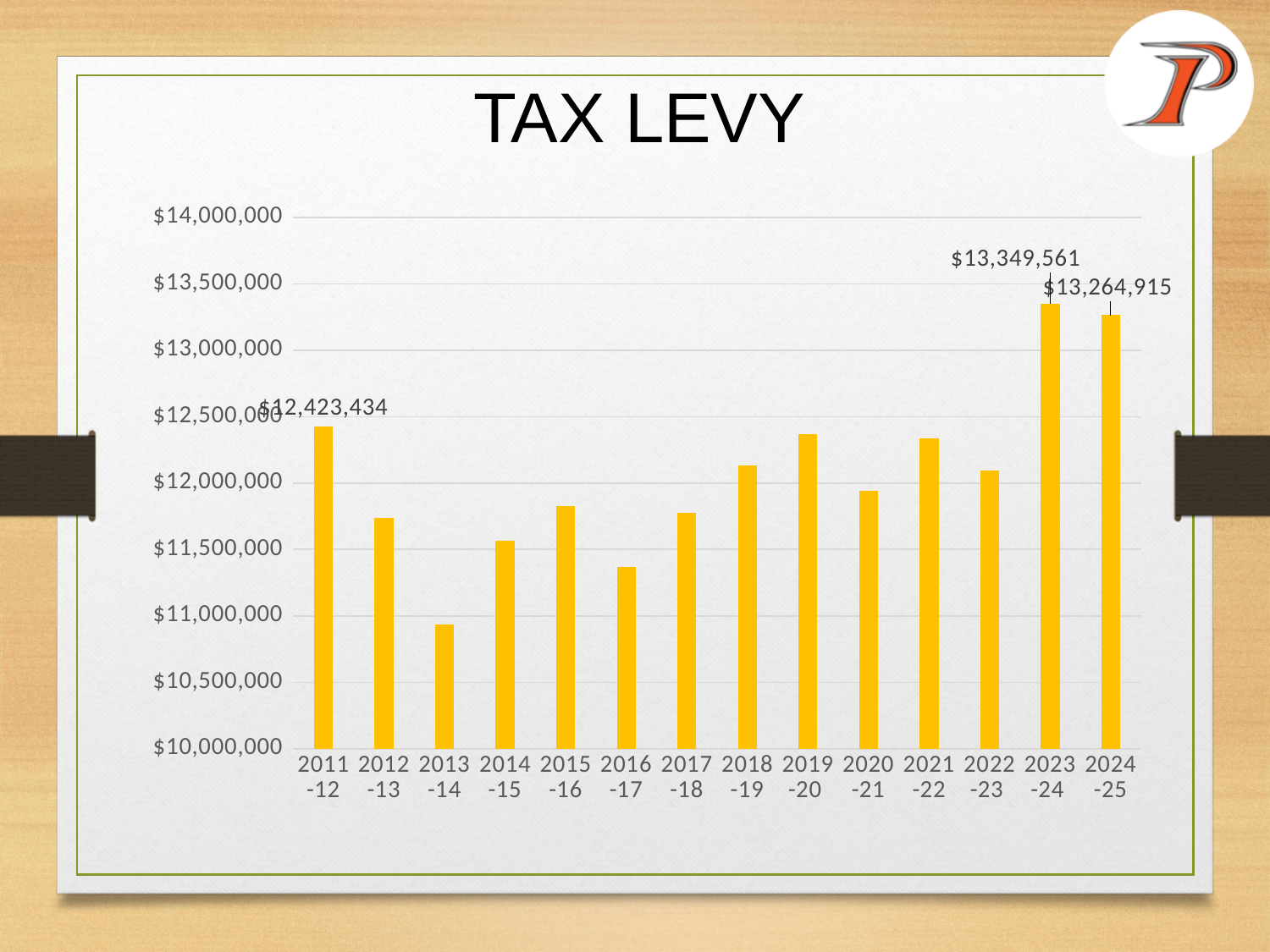
Is the value for 2013-14 greater or less than $11,000,000? less Which is larger, the tax levy for 2019-20 or for 2020-21? 2019-20 Is the value for 2019-20 greater or less than $12,000,000? greater What is the tax levy value for 2024-25? $13,264,915 What is the difference between the tax levy for 2023-24 and 2011-12? $926,127 What kind of chart is shown on the slide? Bar chart Which year has the highest tax levy? 2023-24 How many years are shown on the chart? 14 What is the tax levy value for 2023-24? $13,349,561 Which year has the lowest tax levy? 2013-14 What is the difference between the tax levy for 2023-24 and 2024-25? $84,646 What is the tax levy value for 2011-12? $12,423,434